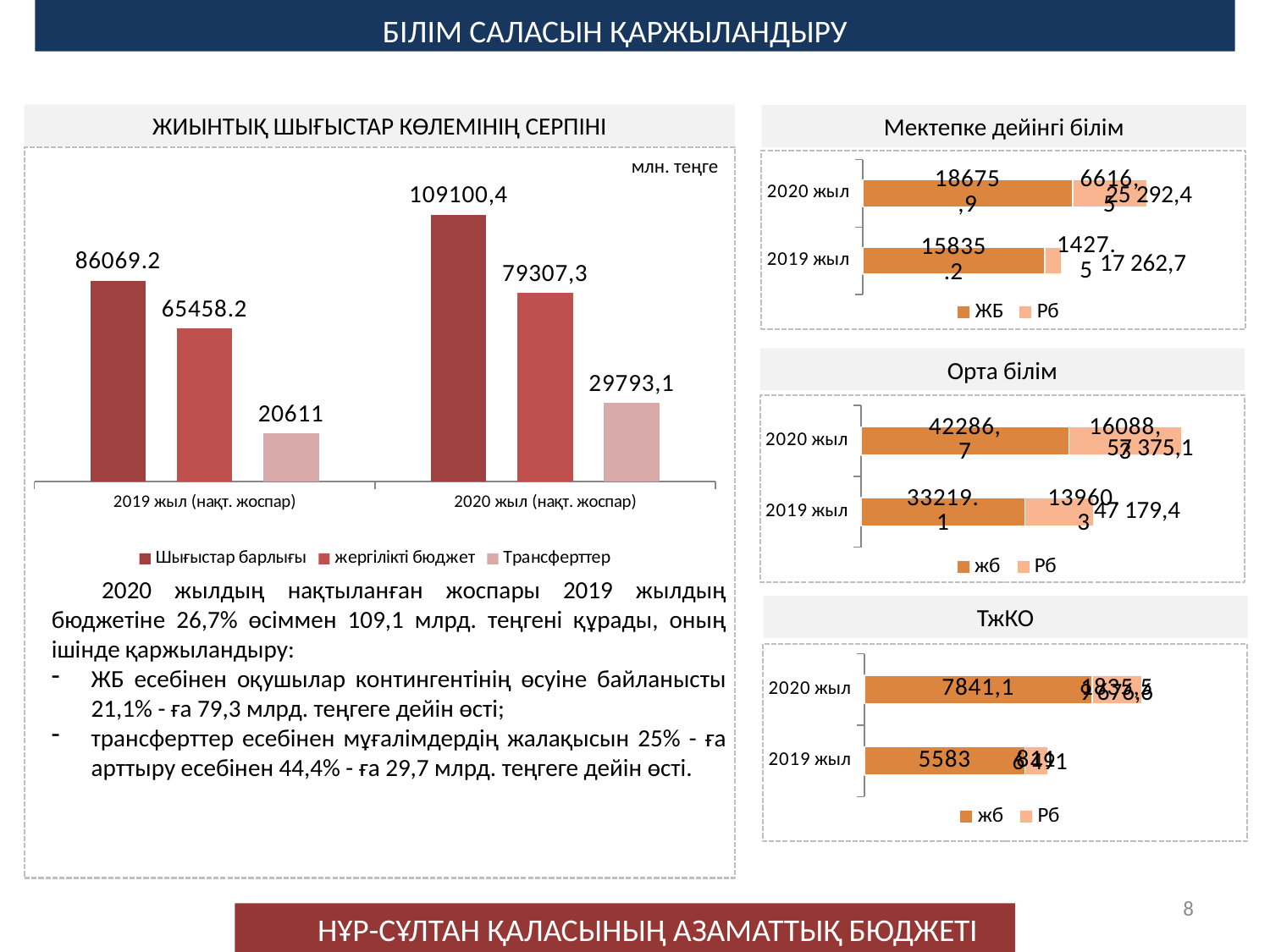
On the chart titled 'Орта білім', what is the value of 'жб' for 2019 жыл? 33219.1 On the chart titled 'ЖИЫНТЫҚ ШЫҒЫСТАР КӨЛЕМІНІҢ СЕРПІНІ', what unit is shown in the top-right corner of the plot area? млн. теңге What kind of chart is the one titled 'ЖИЫНТЫҚ ШЫҒЫСТАР КӨЛЕМІНІҢ СЕРПІНІ'? bar chart On the chart titled 'Мектепке дейінгі білім', what is the value of 'ЖБ' for 2020 жыл? 18675,9 On the chart titled 'ЖИЫНТЫҚ ШЫҒЫСТАР КӨЛЕМІНІҢ СЕРПІНІ', what is the value of 'Трансферттер' for 2019 жыл (нақт. жоспар)? 20611 On the chart titled 'Мектепке дейінгі білім', what is the total of the stacked bar for 2019 жыл? 17 262,7 On the chart titled 'ТжКО', which year has the larger 'жб' value, 2020 жыл or 2019 жыл? 2020 жыл On the chart titled 'ЖИЫНТЫҚ ШЫҒЫСТАР КӨЛЕМІНІҢ СЕРПІНІ', how many series does the legend list? 3 On the chart titled 'ЖИЫНТЫҚ ШЫҒЫСТАР КӨЛЕМІНІҢ СЕРПІНІ', what is the value of 'жергілікті бюджет' for 2020 жыл (нақт. жоспар)? 79307,3 On the chart titled 'ЖИЫНТЫҚ ШЫҒЫСТАР КӨЛЕМІНІҢ СЕРПІНІ', which series has the lowest value for 2020 жыл (нақт. жоспар)? Трансферттер On the chart titled 'ЖИЫНТЫҚ ШЫҒЫСТАР КӨЛЕМІНІҢ СЕРПІНІ', does the value of 'Шығыстар барлығы' rise or fall from 2019 to 2020? rise On the chart titled 'ЖИЫНТЫҚ ШЫҒЫСТАР КӨЛЕМІНІҢ СЕРПІНІ', what is the value of 'Шығыстар барлығы' for 2020 жыл (нақт. жоспар)? 109100,4